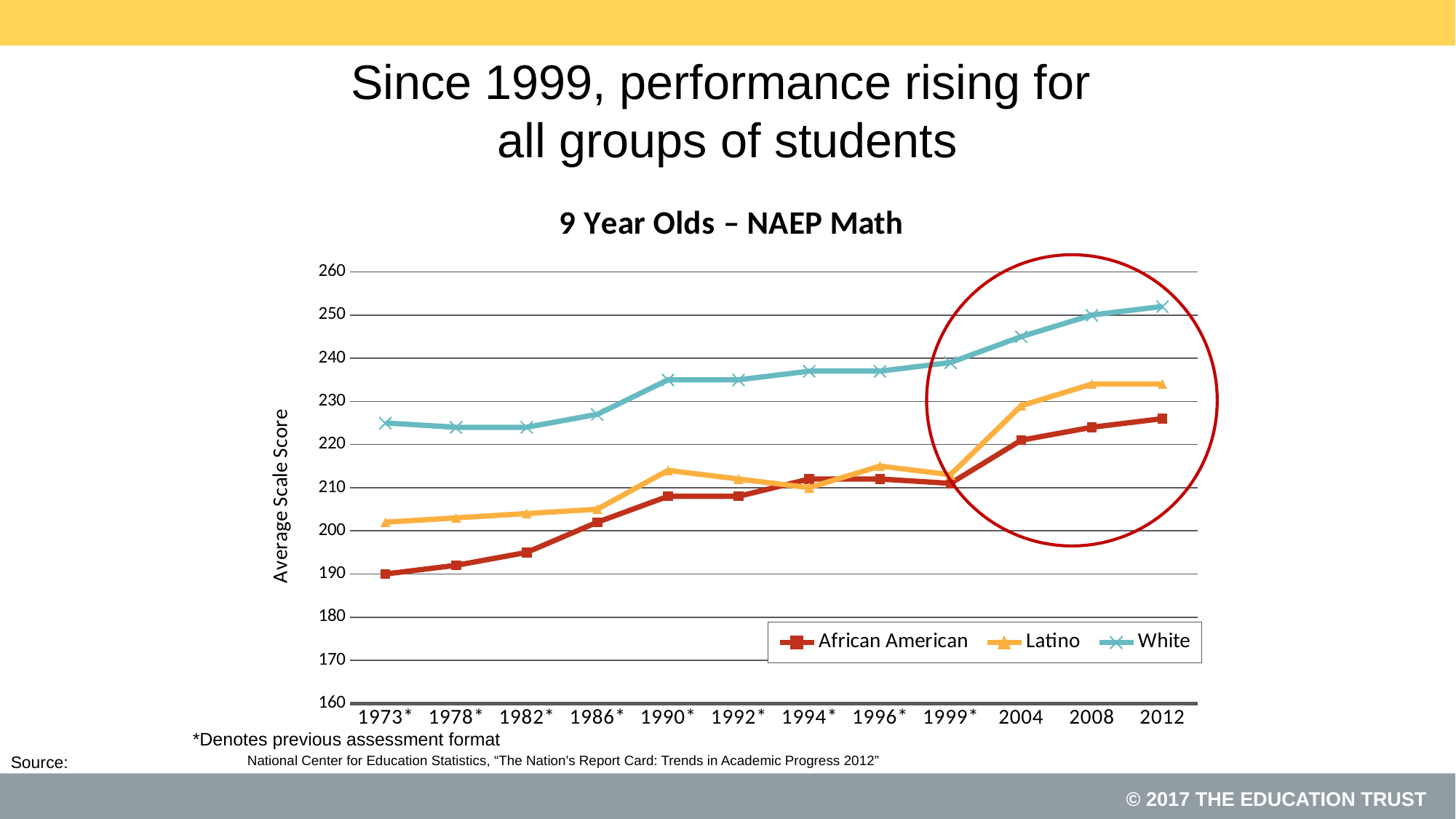
How many series does the legend list? 3 Which group has the highest value in 2012? White What is the value for African American students in 1973*? 190 Is the value for Latino students in 2012 greater or less than 230? greater Which group has the lowest value in 1973*? African American What is the value for White students in 2008? 250 What kind of chart is shown on the slide? Line chart How many years are shown along the x axis? 12 What is the title of the chart? 9 Year Olds – NAEP Math Is the value for White students in 1986* greater or less than 230? less What is the label on the vertical axis? Average Scale Score Is the value for White students in 2012 greater or less than 250? greater